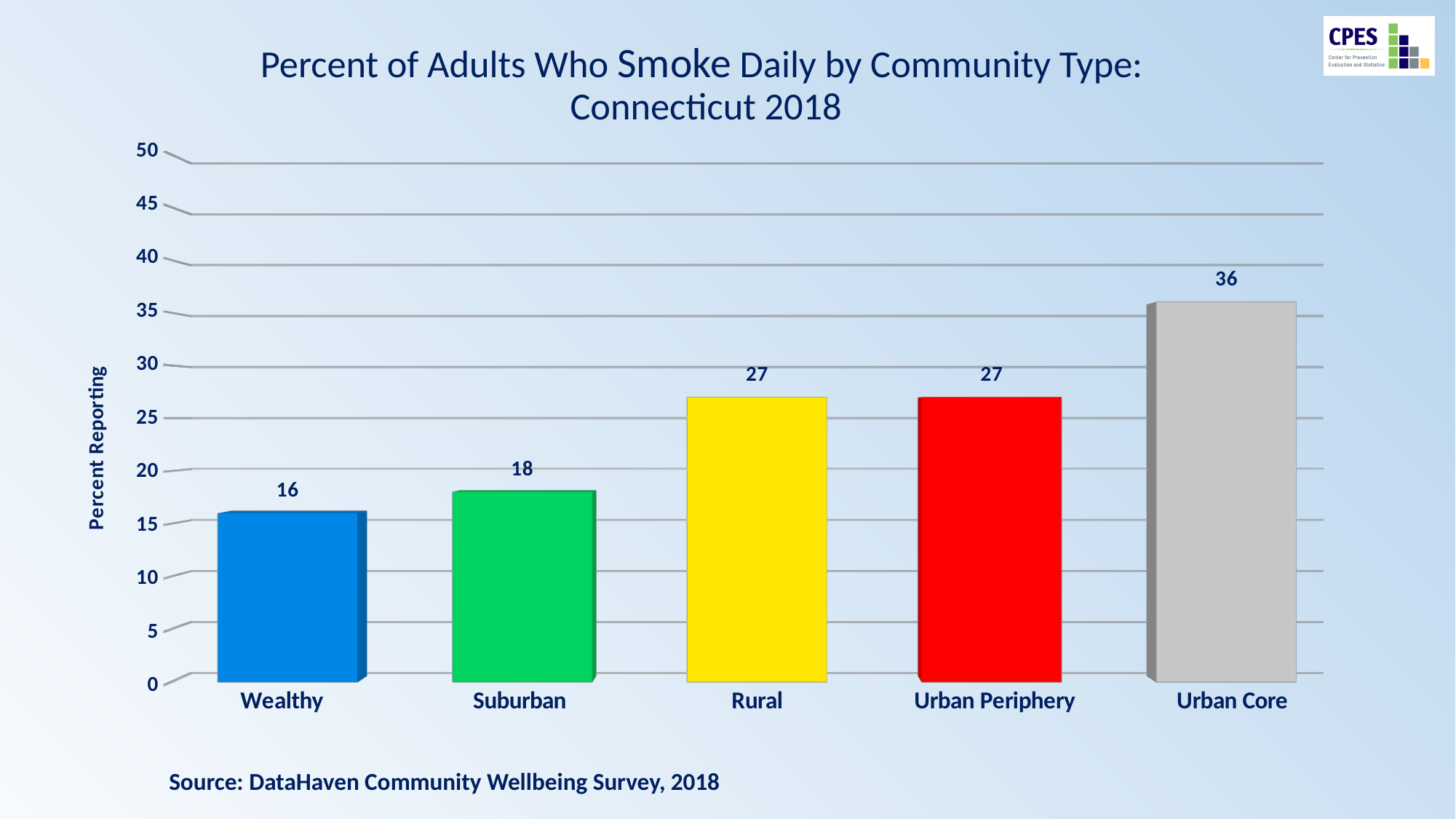
What kind of chart is shown on the slide? bar chart What is the value for Urban Core? 36 Is the value for Urban Core greater or less than 30? greater What is the value for Suburban? 18 What is the difference between the values for Urban Core and Wealthy? 20 What is the difference between the values for Rural and Suburban? 9 Which is larger, the value for Suburban or the value for Urban Periphery? Urban Periphery What is the value for Wealthy? 16 What is the label of the vertical axis? Percent Reporting Which community type has the lowest percent reporting? Wealthy How many community types are shown on the chart? 5 Which community type has the highest percent reporting? Urban Core